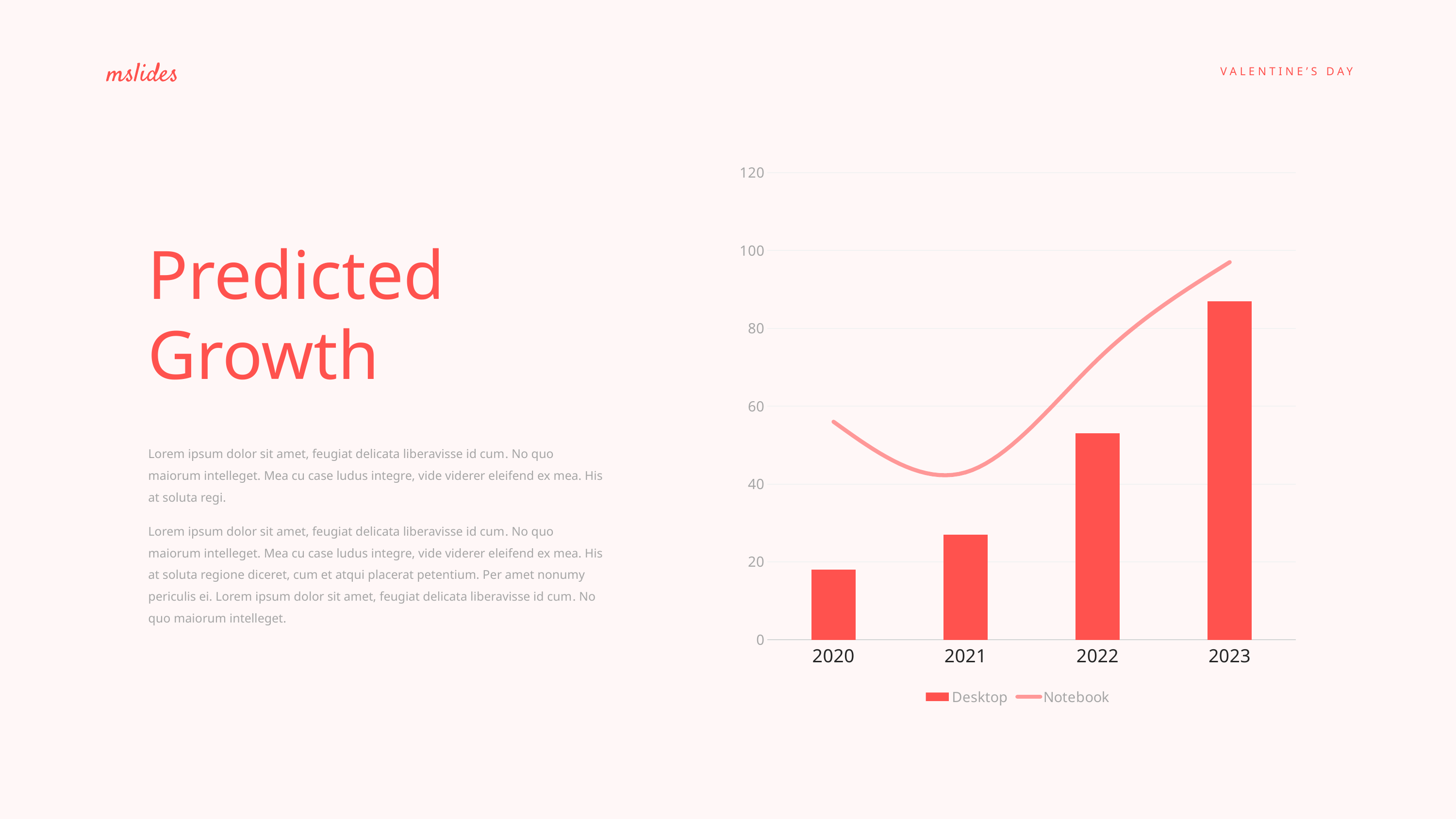
Do the Desktop values rise or fall from 2020 to 2023? rise How many series does the chart legend list? 2 Is the Desktop value for 2020 greater or less than 20? less How many years are shown on the x axis of the chart? 4 Is the Desktop value for 2022 greater or less than 60? less Which year has the lowest Notebook value? 2021 Which year has the lowest Desktop value? 2020 Is the Notebook value for 2022 greater or less than 60? greater Which year has the highest Desktop value? 2023 In 2020, which is larger, the Desktop value or the Notebook value? Notebook Which series is drawn as a line rather than bars? Notebook